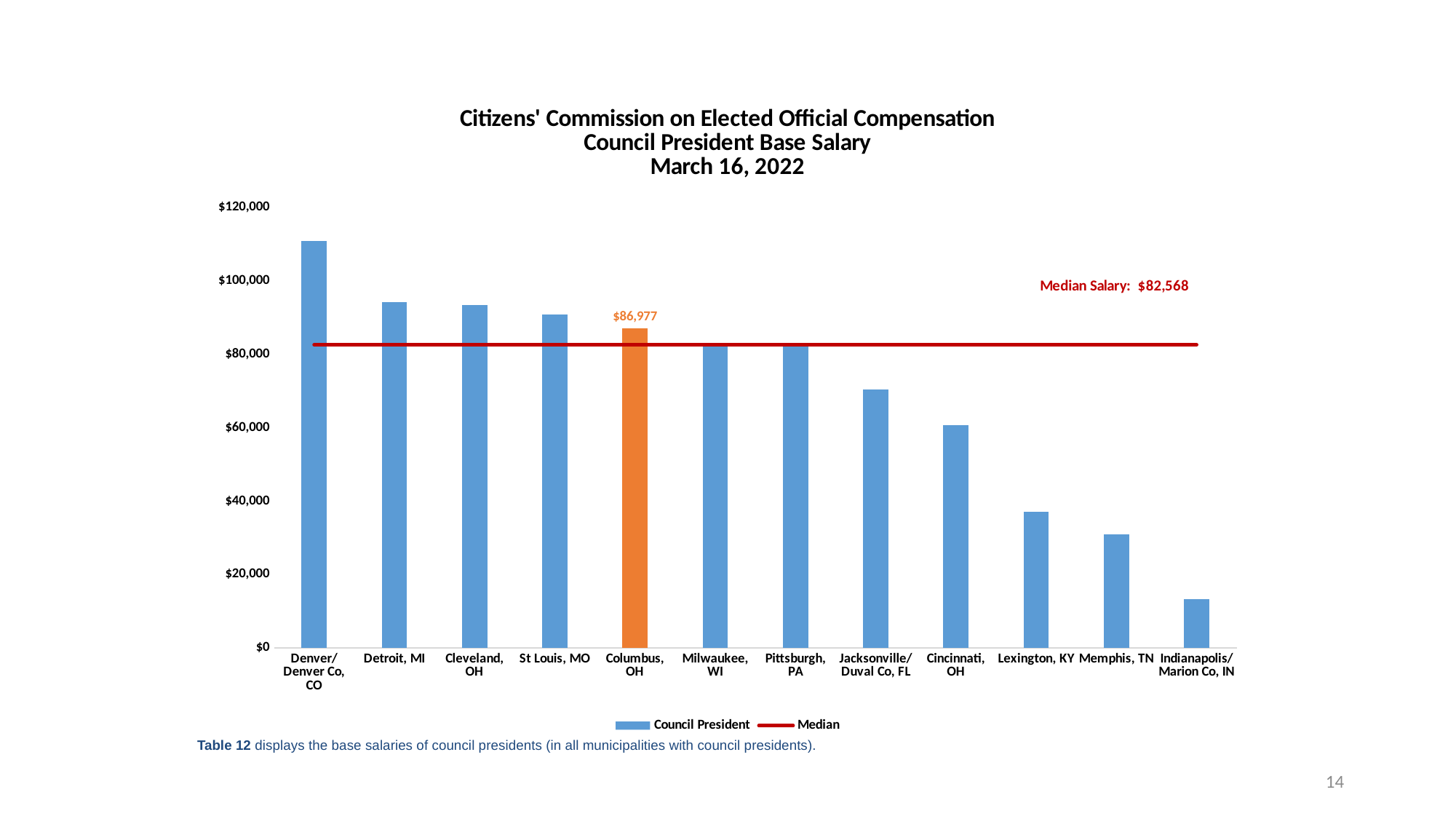
Which city has the highest council president base salary? Denver/Denver Co, CO Do the bar values rise or fall from left to right across the chart? Fall Is the value for Denver/Denver Co, CO greater or less than $100,000? greater By how much does the Columbus, OH salary exceed the median salary? $4,409 Is the value for Indianapolis/Marion Co, IN greater or less than $20,000? less How many entries does the legend list? 2 Which city has the lowest council president base salary? Indianapolis/Marion Co, IN Which city's bar is coloured orange? Columbus, OH How many cities are shown on the chart? 12 What is the council president base salary shown for Columbus, OH? $86,977 What kind of chart is shown on the slide? Bar chart with a median line (combination bar and line chart) What median salary is printed on the chart? $82,568